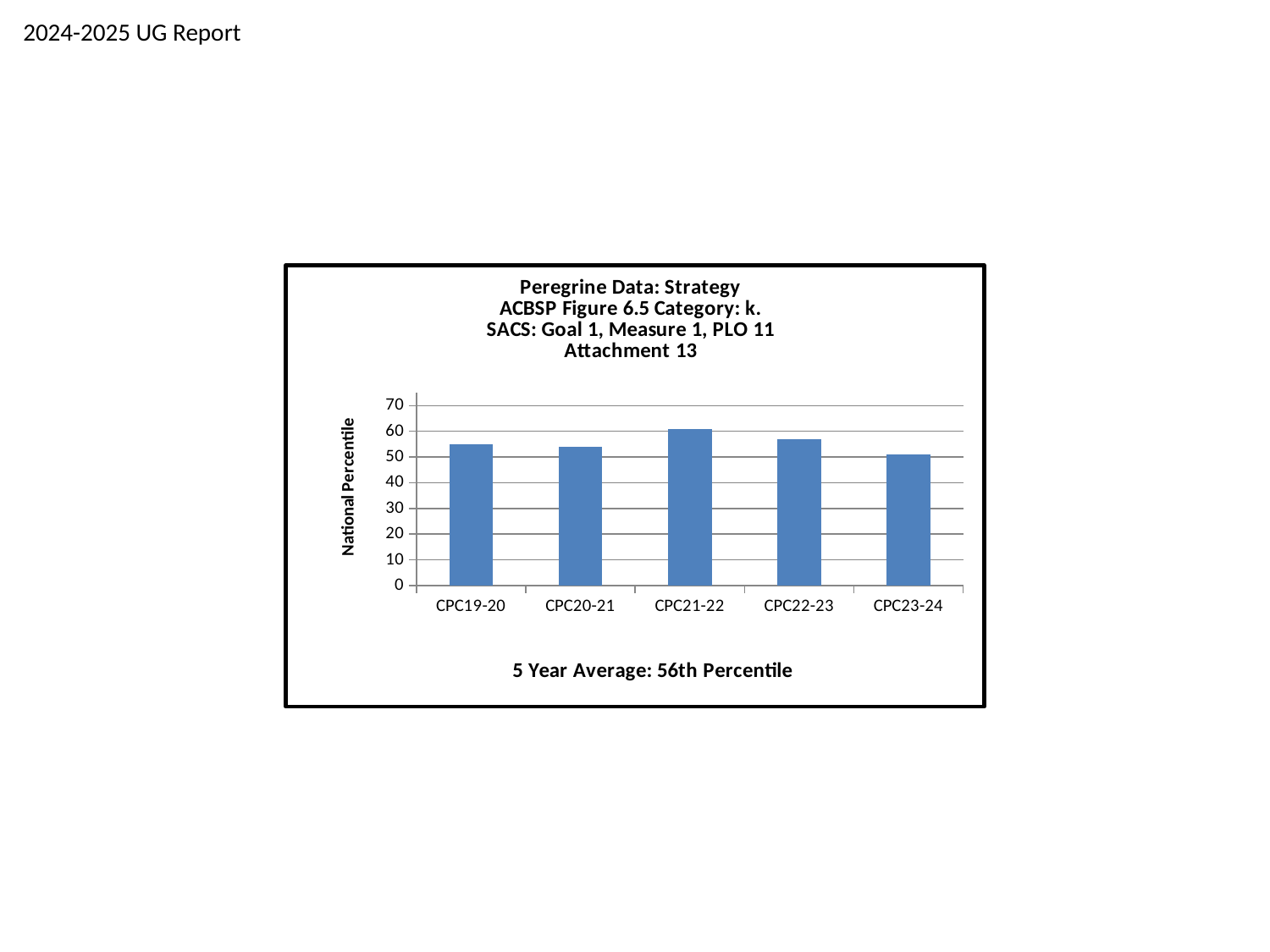
Which category has the lowest National Percentile? CPC23-24 Is the value for CPC23-24 greater or less than 60? less What 5 year average is stated below the chart? 56th Percentile Which is larger, the value for CPC21-22 or the value for CPC23-24? CPC21-22 Which category has the highest National Percentile? CPC21-22 Is the value for CPC22-23 greater or less than 60? less What is the label on the vertical axis of the chart? National Percentile Do the values rise or fall from CPC21-22 to CPC23-24? fall How many categories are plotted on the x axis of the chart? 5 Is the value for CPC19-20 greater or less than 50? greater What kind of chart is shown on the slide? bar chart